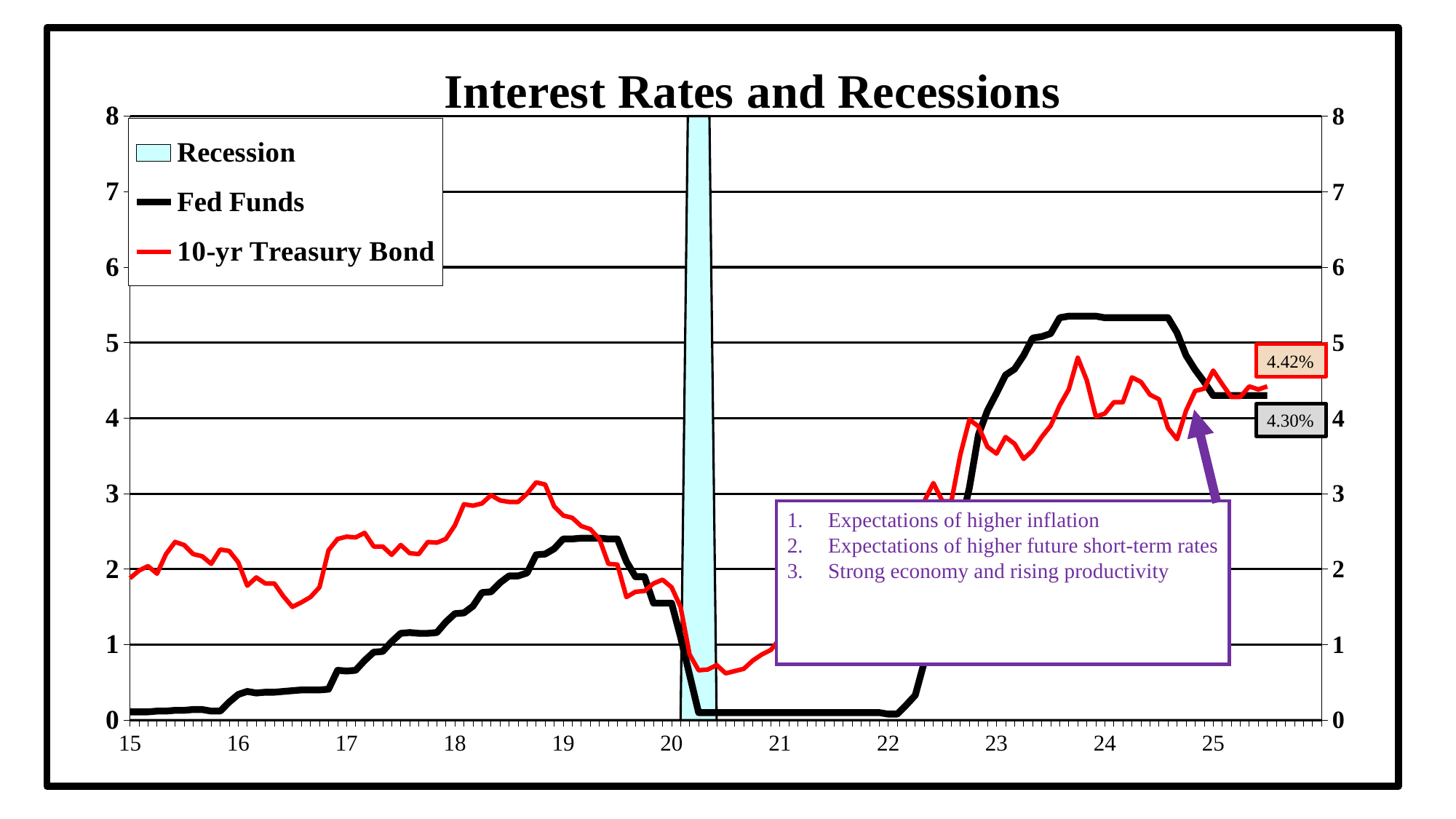
What is the difference between the labelled 10-yr Treasury Bond value (4.42%) and the labelled Fed Funds value (4.30%)? 0.12% How many recession periods are shaded on the chart? 1 At the end of the chart, which is higher: the 10-yr Treasury Bond or Fed Funds? 10-yr Treasury Bond How many entries does the chart's legend list? 3 What is the title of the chart? Interest Rates and Recessions What kind of chart is shown on the slide? line chart Is the Fed Funds rate during 2021 greater or less than 1? less Is the 10-yr Treasury Bond rate at the start of 2015 greater or less than 3? less Does the Fed Funds rate rise or fall between 2022 and 2023? rises What is the latest labelled value for the 10-yr Treasury Bond? 4.42% What is the latest labelled value for Fed Funds? 4.30%